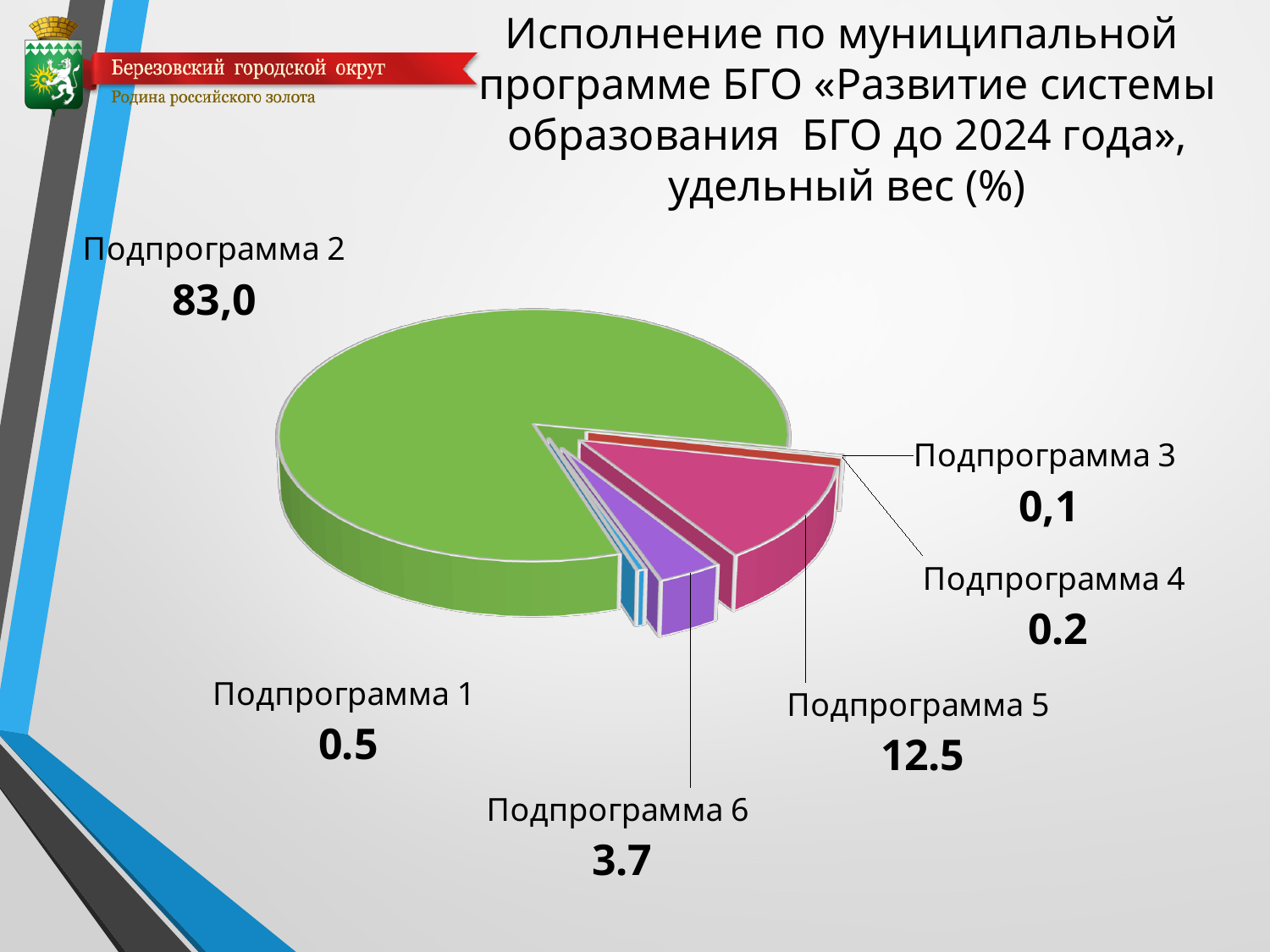
What is the difference between the values for Подпрограмма 5 and Подпрограмма 6? 8.8 How many subprograms (slices) are shown in the pie chart? 6 What is the value for Подпрограмма 3 in the pie chart? 0,1 Which subprogram has the largest share of the pie? Подпрограмма 2 What kind of chart is shown on the slide? Pie chart Which is larger, the value for Подпрограмма 1 or the value for Подпрограмма 6? Подпрограмма 6 What colour is the slice for Подпрограмма 2? Green Which subprogram has the smallest share of the pie? Подпрограмма 3 What is the value for Подпрограмма 4 in the pie chart? 0.2 What is the value for Подпрограмма 2 in the pie chart? 83,0 What is the value for Подпрограмма 6 in the pie chart? 3.7 What is the value for Подпрограмма 5 in the pie chart? 12.5